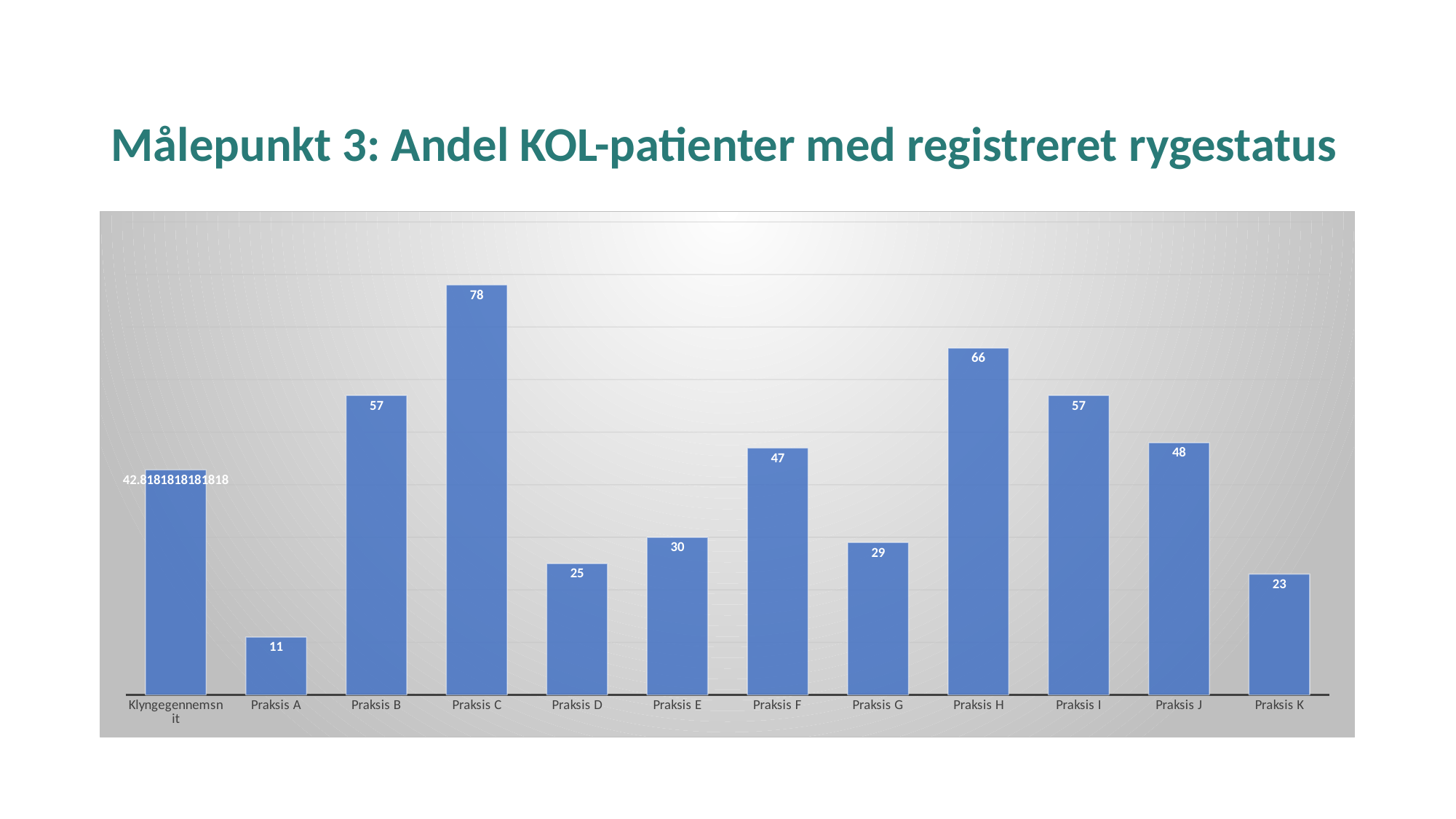
What is the difference between the values for Praksis B and Praksis D? 32 Which category has the highest value? Praksis C Which is larger, the value for Praksis F or the value for Praksis J? Praksis J What is the value for Praksis C? 78 What kind of chart is shown on the slide? Bar chart Which category has the lowest value? Praksis A How many categories are shown on the x axis? 12 What is the value for Praksis A? 11 What value is shown for Klyngegennemsnit? 42.8181818181818 What is the title of the slide? Målepunkt 3: Andel KOL-patienter med registreret rygestatus What is the value for Praksis G? 29 What is the difference between the values for Praksis H and Praksis K? 43